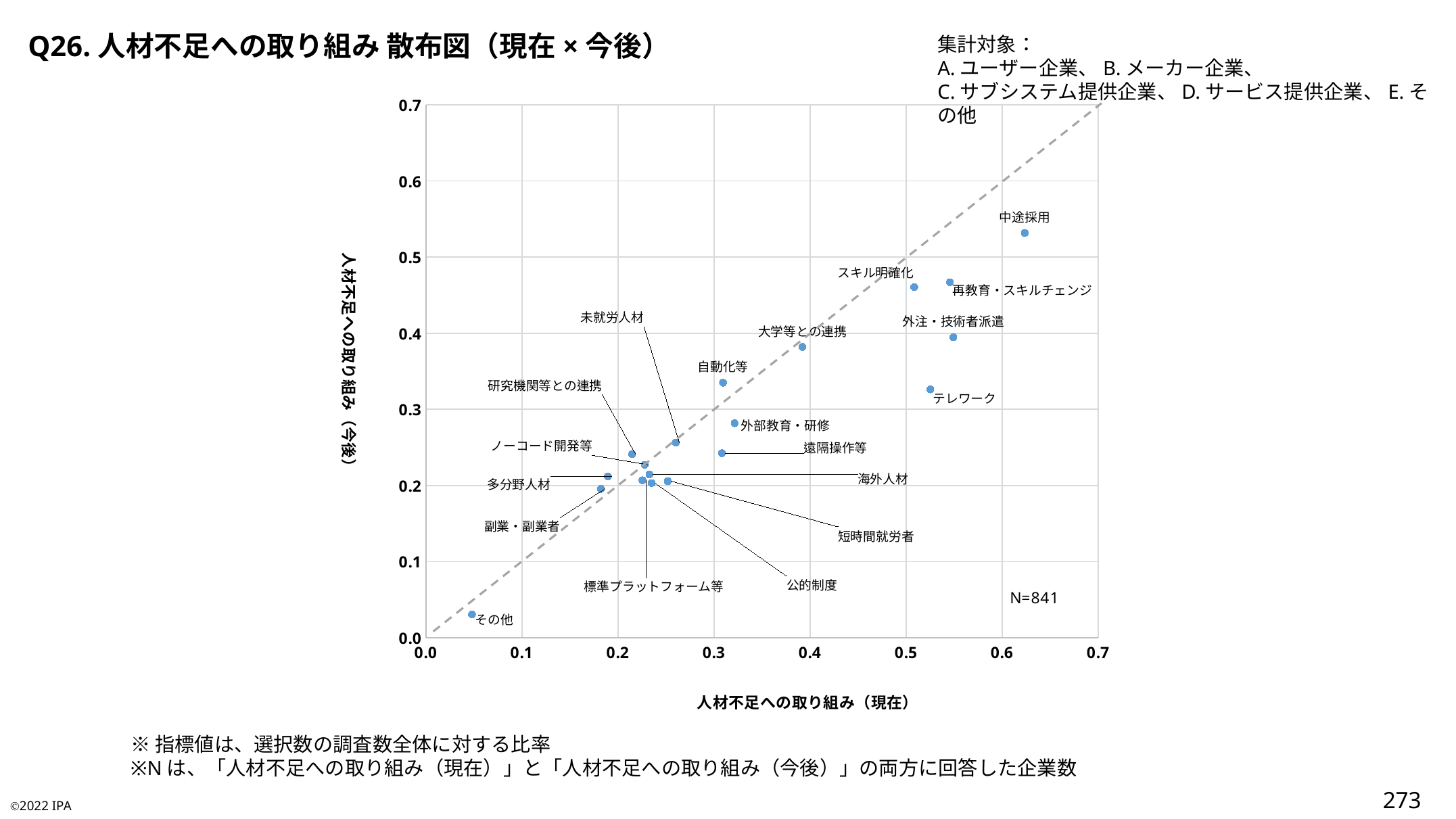
Which item has the highest value on the vertical axis 人材不足への取り組み（今後）? 中途採用 What kind of chart is shown on the slide? Scatter chart Which has the larger 今後 (vertical axis) value, 自動化等 or 遠隔操作等? 自動化等 Which has the larger 現在 (horizontal axis) value, テレワーク or 大学等との連携? テレワーク Is the 今後 (vertical axis) value for 中途採用 greater or less than 0.5? greater Is the 現在 (horizontal axis) value for その他 greater or less than 0.1? less How many labelled data points are plotted in the scatter chart? 19 Is the 現在 (horizontal axis) value for 中途採用 greater or less than 0.6? greater What is the N value shown in the chart? N=841 Which item has the lowest value on the horizontal axis 人材不足への取り組み（現在）? その他